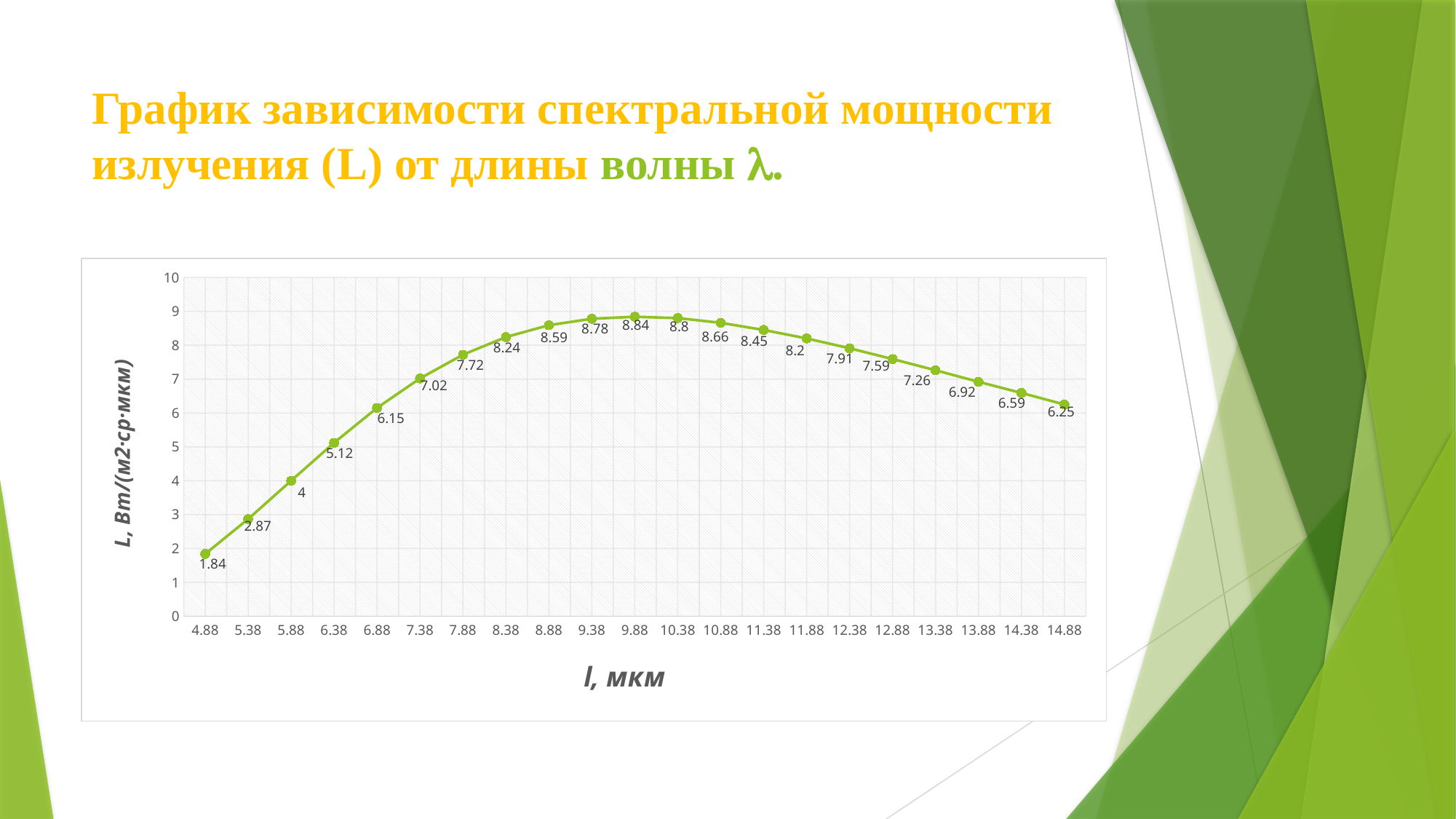
Which is larger: the value of L at 6.88 мкм or at 13.88 мкм? 13.88 мкм At which wavelength l does L reach its highest value? 9.88 What is the value of L at l = 9.88 мкм? 8.84 At which wavelength l is L the lowest? 4.88 Is the value of L at l = 5.88 мкм greater or less than 5? less What is the label of the vertical axis? L, Вт/(м2·ср·мкм) What type of chart is shown on the slide? line chart What is the value of L at l = 7.38 мкм? 7.02 What is the value of L at l = 4.88 мкм? 1.84 What is the value of L at l = 14.88 мкм? 6.25 What is the difference between the value of L at 9.88 мкм and at 14.88 мкм? 2.59 How many data points are plotted on the chart? 21